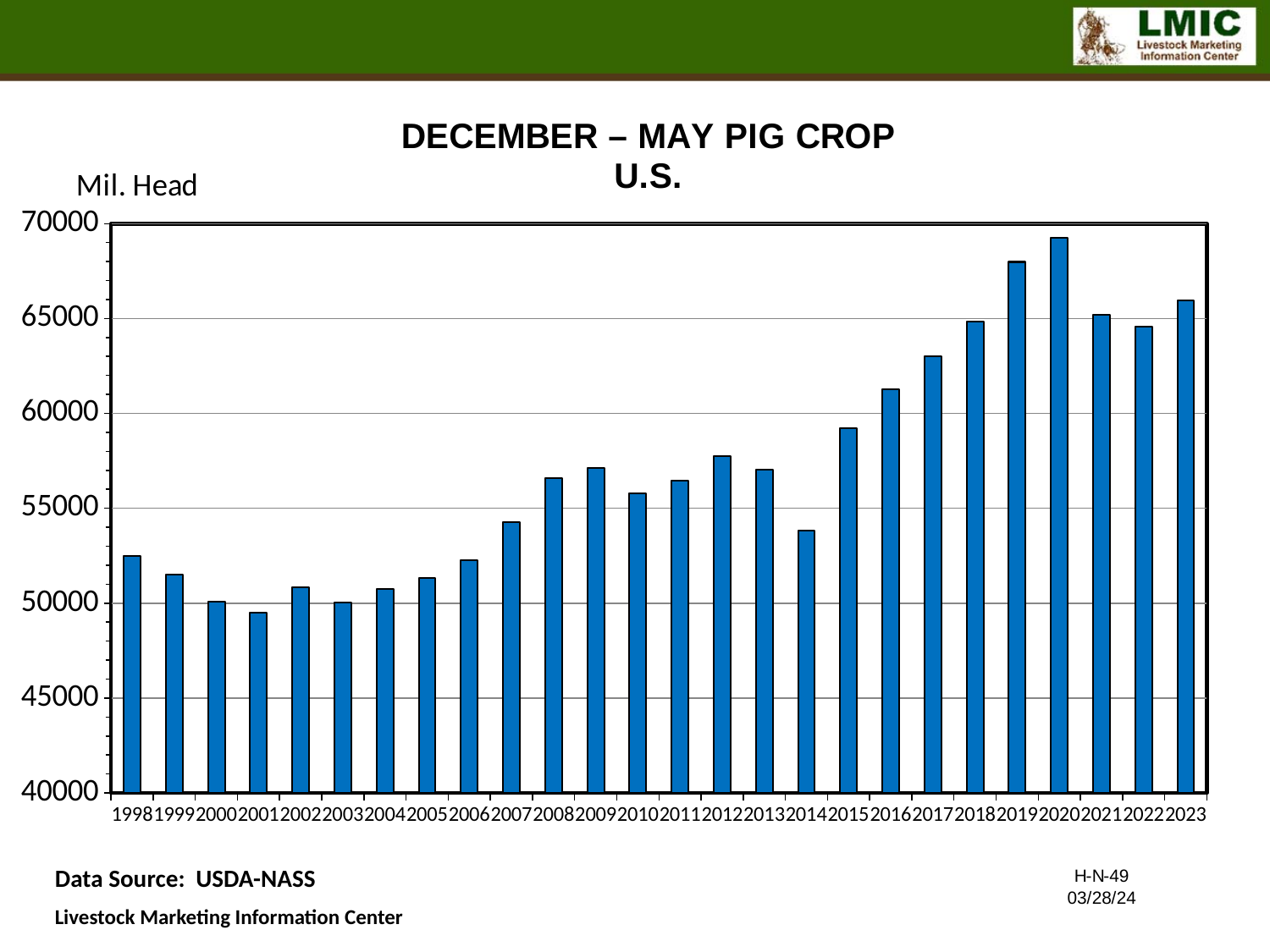
Which year has the highest December–May pig crop? 2020 What kind of chart is shown on the slide? bar chart How many years (bars) are plotted on the chart? 26 Is the value for 2008 greater or less than 55000? greater Is the value for 2020 greater or less than 65000? greater What unit label is shown above the y axis? Mil. Head Is the value for 2014 greater or less than 55000? less Which is larger, the value for 2022 or the value for 2023? 2023 Do the values rise or fall from 2014 to 2020? rise Which is larger, the value for 2014 or the value for 2015? 2015